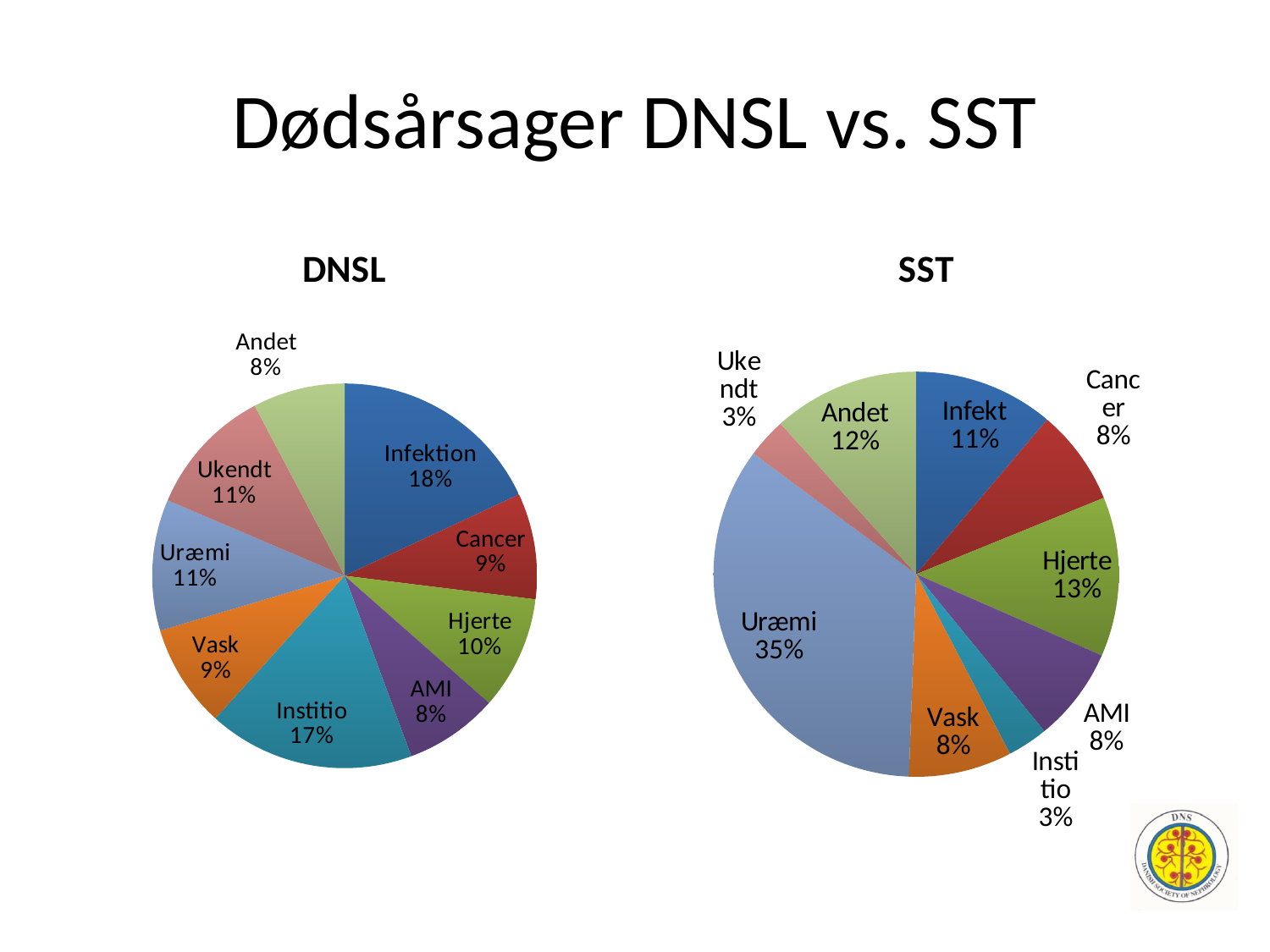
In the SST pie chart, what share does Uræmi have? 35% In the SST pie chart, which is larger: the share for Andet or the share for Infekt? Andet In the SST pie chart, how many categories are shown? 9 What is the title of the slide? Dødsårsager DNSL vs. SST In the DNSL pie chart, what share does Infektion have? 18% In the DNSL pie chart, what is the share for Institio? 17% What is the difference between the Uræmi share in the SST chart and the Uræmi share in the DNSL chart? 24 percentage points In the SST pie chart, which category has the largest share? Uræmi In the DNSL pie chart, how many categories are shown? 9 In the SST pie chart, what is the share for Hjerte? 13% In the DNSL pie chart, which category has the largest share? Infektion What type of chart is used on this slide? Pie chart